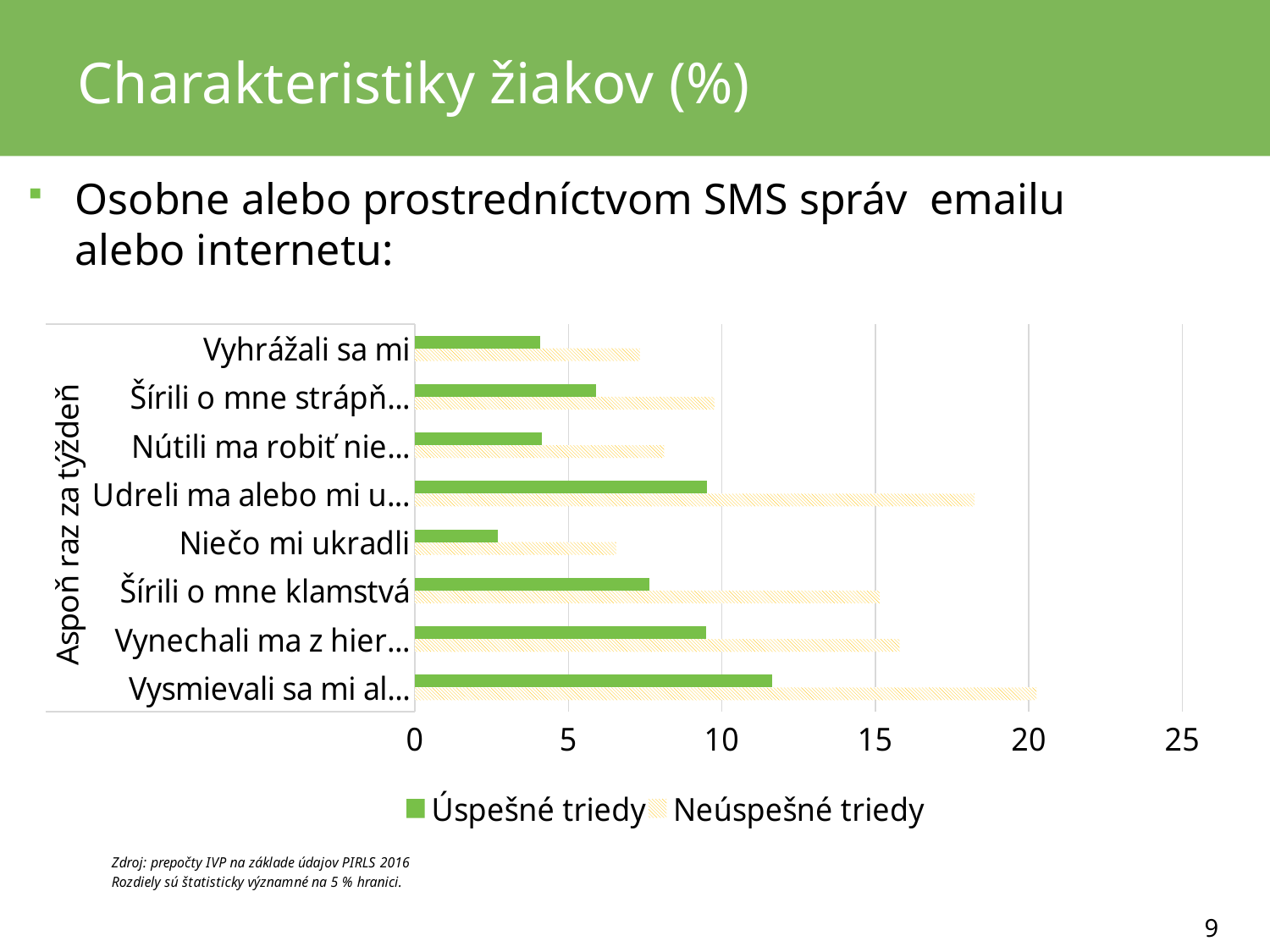
How many categories are plotted on the chart? 8 Is the value for Úspešné triedy in the category 'Šírili o mne klamstvá' greater or less than 10? less Which category has the lowest value for Úspešné triedy? Niečo mi ukradli Is the value for Neúspešné triedy in the category 'Niečo mi ukradli' greater or less than 5? greater What is the title of the vertical axis of the chart? Aspoň raz za týždeň Is the value for Úspešné triedy in the category 'Vyhrážali sa mi' greater or less than 5? less In the category 'Vyhrážali sa mi', which series has the larger value: Úspešné triedy or Neúspešné triedy? Neúspešné triedy Which two series are listed in the chart legend? Úspešné triedy, Neúspešné triedy How many series does the chart legend list? 2 What kind of chart is shown on the slide? bar chart For Úspešné triedy, which is larger: 'Niečo mi ukradli' or 'Šírili o mne klamstvá'? Šírili o mne klamstvá